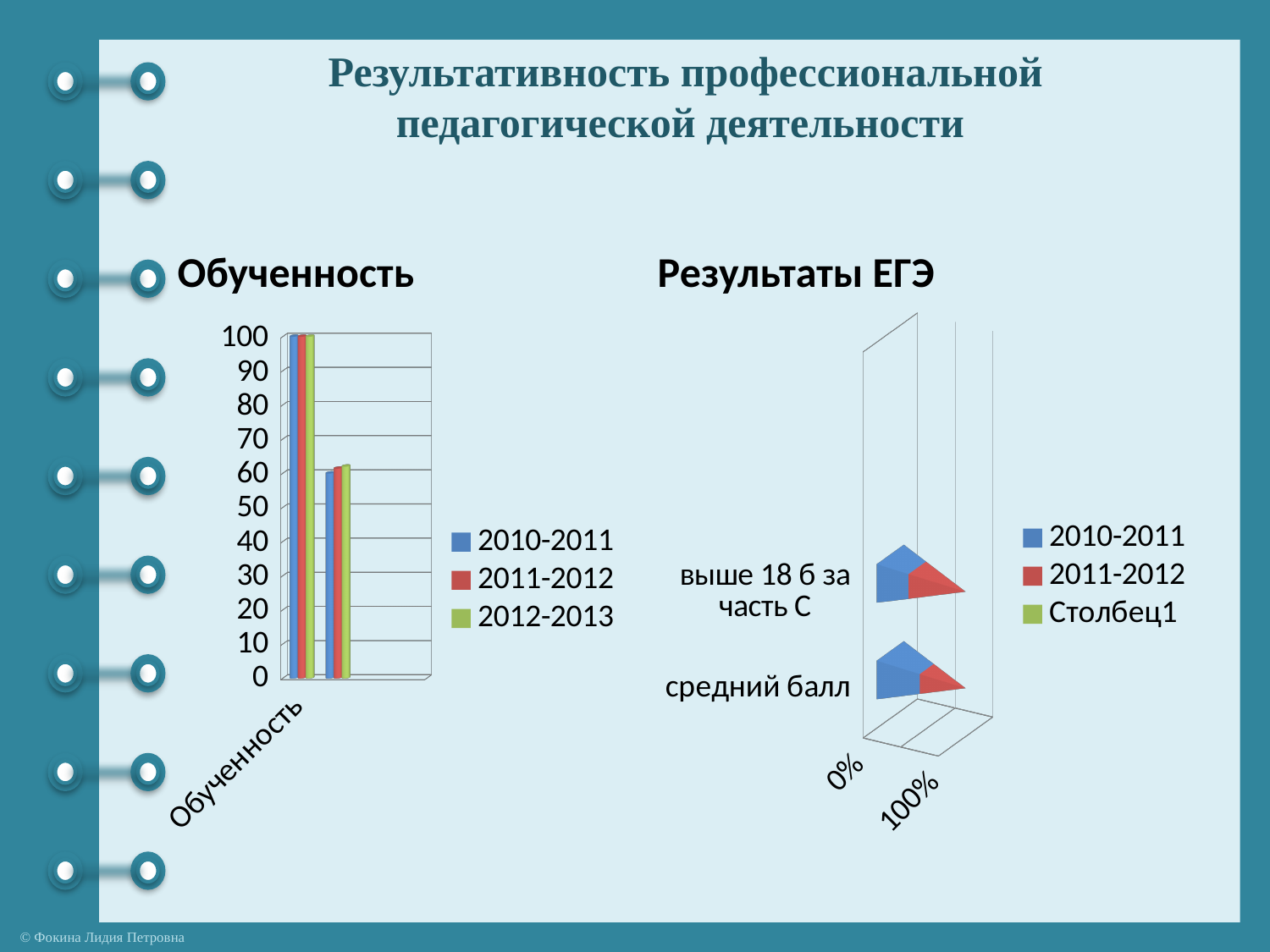
In the 'Результаты ЕГЭ' chart, is the value for 'средний балл' in 2010-2011 greater or less than 100%? less In the 'Обученность' chart, what value do the tallest bars reach on the vertical axis? 100 In the 'Обученность' chart, is the value of the tallest bars greater or less than 90? greater How many categories are shown on the vertical axis of the 'Результаты ЕГЭ' chart? 2 How many series does the legend of the 'Результаты ЕГЭ' chart list? 3 What kind of chart is the 'Обученность' chart on the left? bar chart In the 'Обученность' chart, is the value of the shorter group of bars greater or less than 50? greater What are the two category labels in the 'Результаты ЕГЭ' chart? выше 18 б за часть С; средний балл What is the highest tick value shown on the vertical axis of the 'Обученность' chart? 100 How many series does the legend of the 'Обученность' chart list? 3